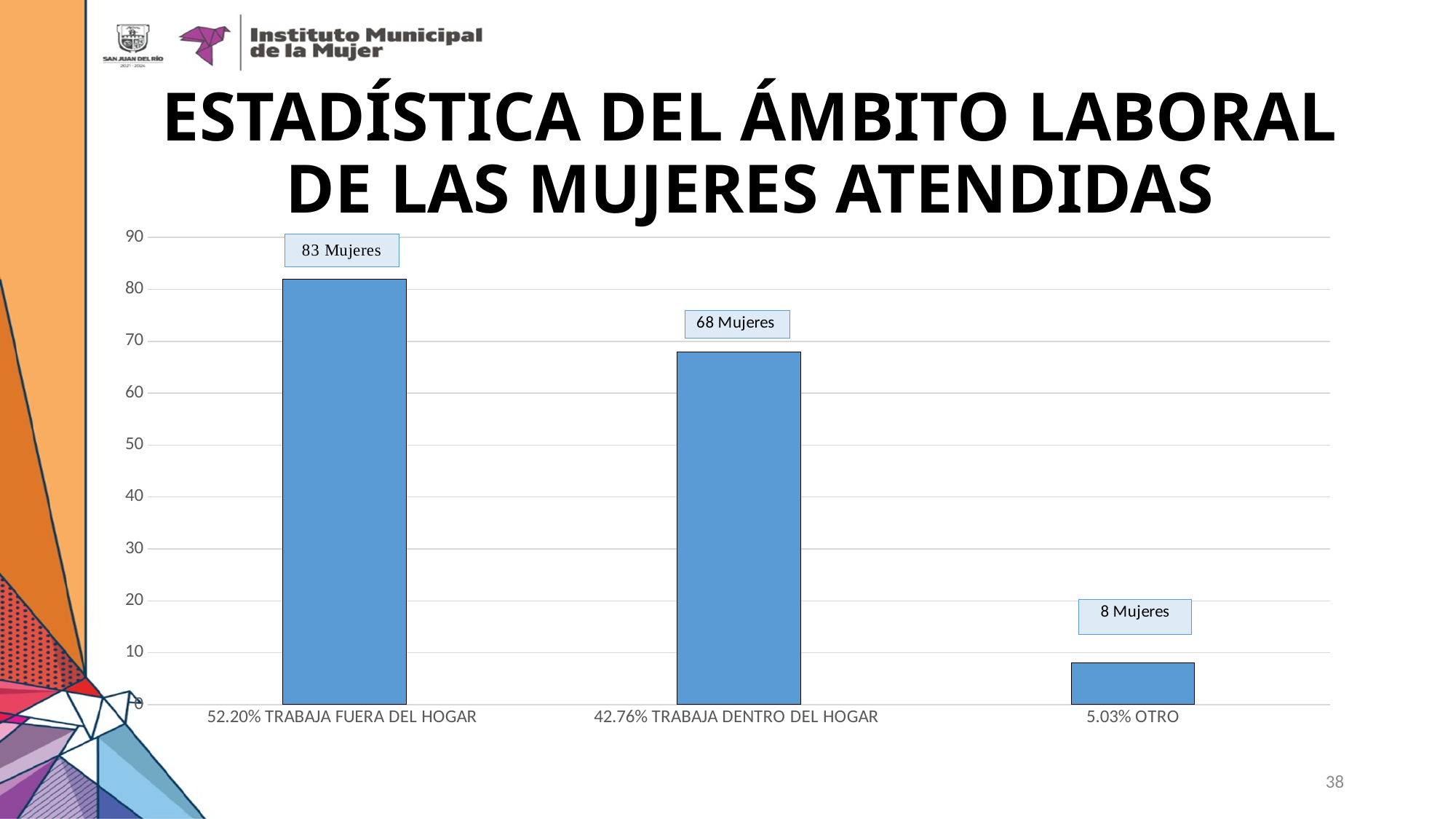
Which is larger: the value for 'TRABAJA DENTRO DEL HOGAR' or the value for 'OTRO'? TRABAJA DENTRO DEL HOGAR Is the value for '5.03% OTRO' greater or less than 10? less Which category has the lowest bar? 5.03% OTRO What is the title of the slide containing the chart? ESTADÍSTICA DEL ÁMBITO LABORAL DE LAS MUJERES ATENDIDAS How many categories are shown on the chart? 3 What type of chart is shown on the slide? Bar chart How many women are shown for the category '42.76% TRABAJA DENTRO DEL HOGAR'? 68 Mujeres How many women are shown for the category '5.03% OTRO'? 8 Mujeres How many women are shown for the category '52.20% TRABAJA FUERA DEL HOGAR'? 83 Mujeres What is the difference between the number of women for '42.76% TRABAJA DENTRO DEL HOGAR' and '5.03% OTRO'? 60 Is the value for '42.76% TRABAJA DENTRO DEL HOGAR' greater or less than 60? greater Which category has the highest bar? 52.20% TRABAJA FUERA DEL HOGAR